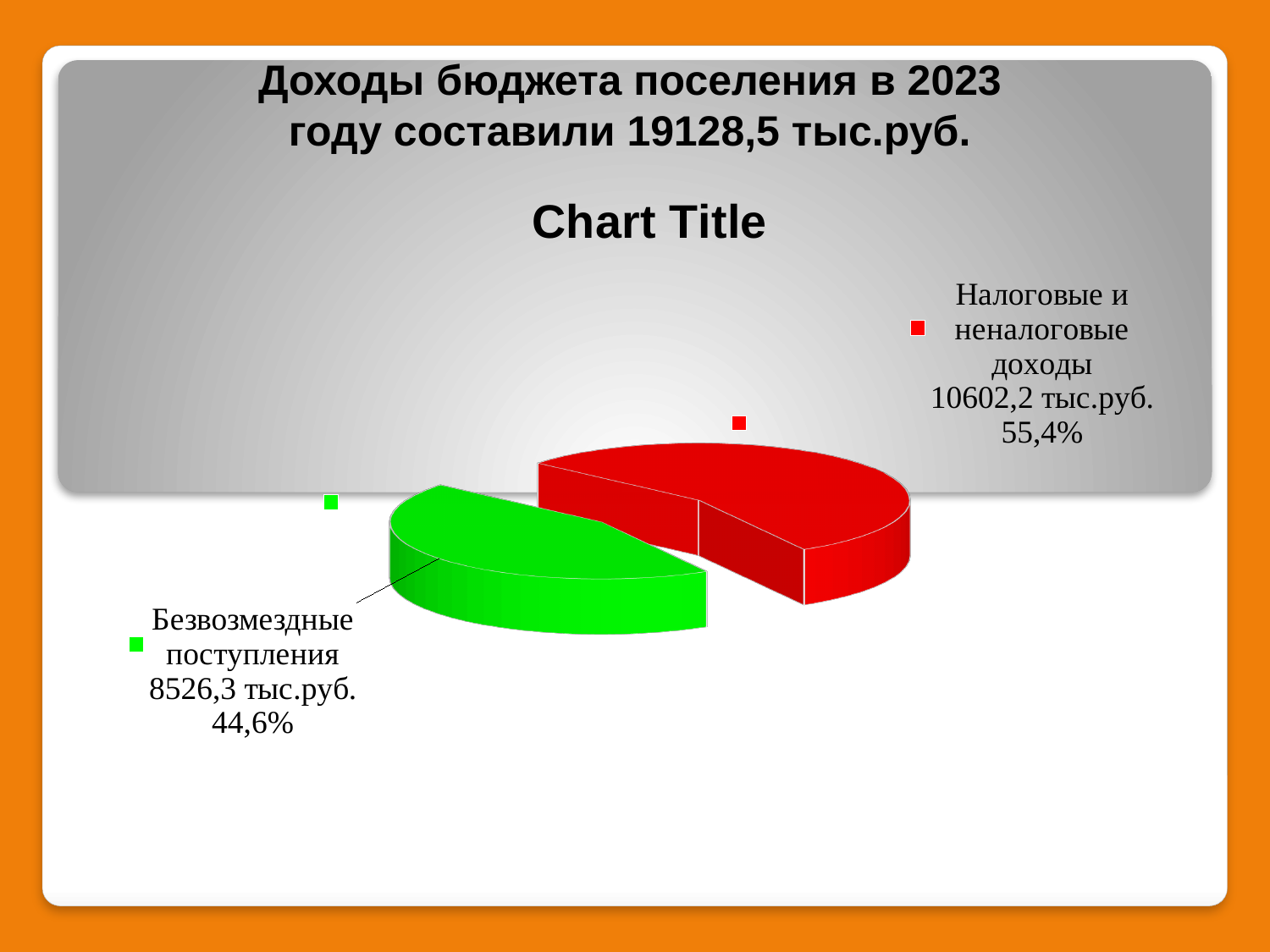
Which category has the smallest slice of the pie? Безвозмездные поступления What share of the pie does Безвозмездные поступления represent? 44,6% What is the title printed above the pie chart? Chart Title What colour is the slice for Безвозмездные поступления? green What is the difference in percentage points between the share of Налоговые и неналоговые доходы and the share of Безвозмездные поступления? 10,8 What is the value shown for Безвозмездные поступления? 8526,3 тыс.руб. What share of the pie does Налоговые и неналоговые доходы represent? 55,4% Which category has the largest slice of the pie? Налоговые и неналоговые доходы How many slices does the pie chart have? 2 What is the value shown for Налоговые и неналоговые доходы? 10602,2 тыс.руб. What kind of chart is shown on the slide? pie chart Which is larger: Налоговые и неналоговые доходы or Безвозмездные поступления? Налоговые и неналоговые доходы